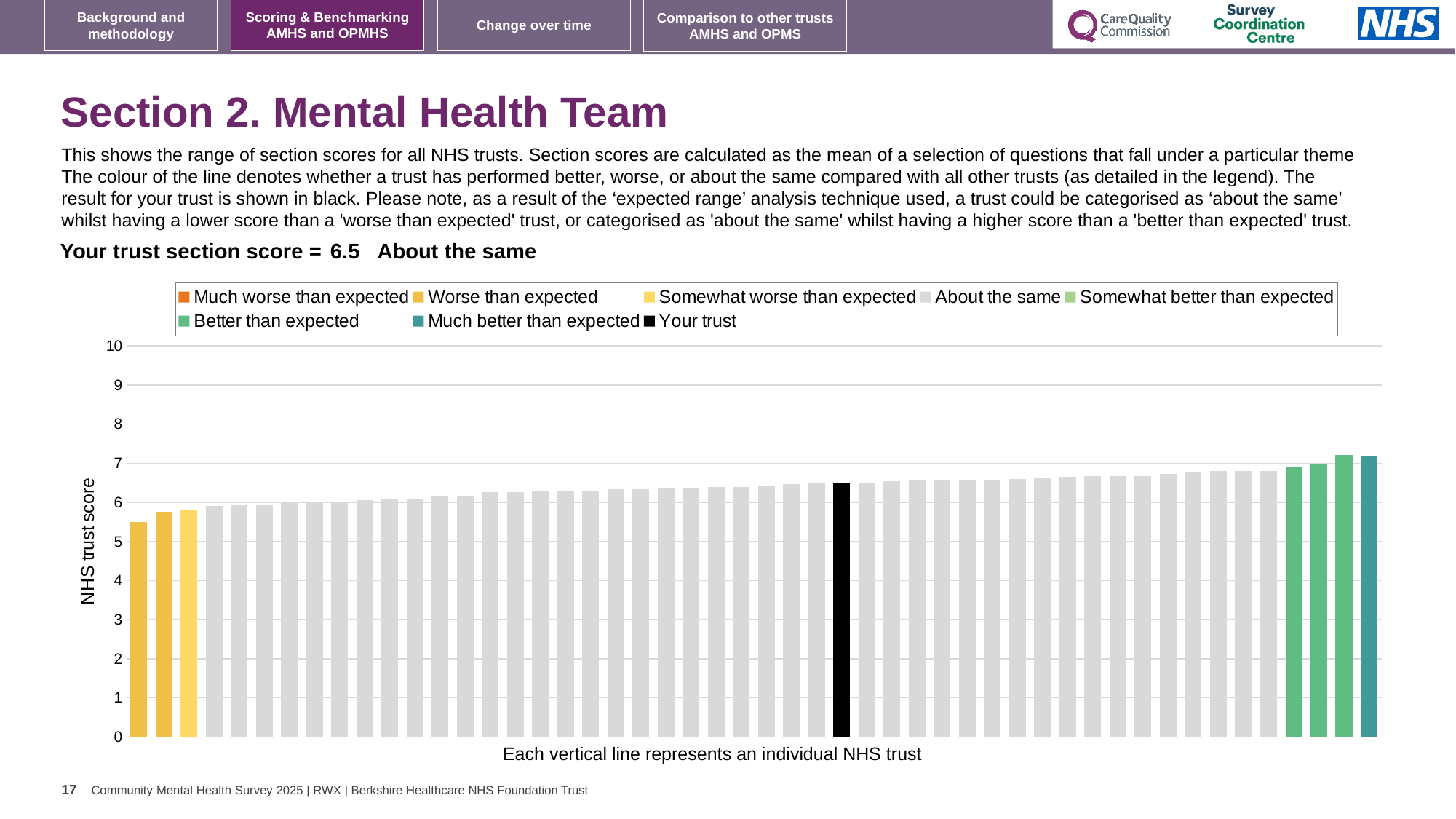
How many entries does the chart legend list? 8 Do the bar values rise or fall from left to right along the x axis? rise Is the value of the lowest bar greater or less than 6? less What category is your trust placed in according to the slide? About the same What is the maximum value shown on the vertical axis? 10 What kind of chart is shown on the slide? bar chart What is the label on the vertical axis of the chart? NHS trust score Is the value of the highest bar greater or less than 8? less Is the value for your trust (the black bar) greater or less than 6? greater What is the section score for your trust shown on the slide? 6.5 How many bars on the chart are coloured black? 1